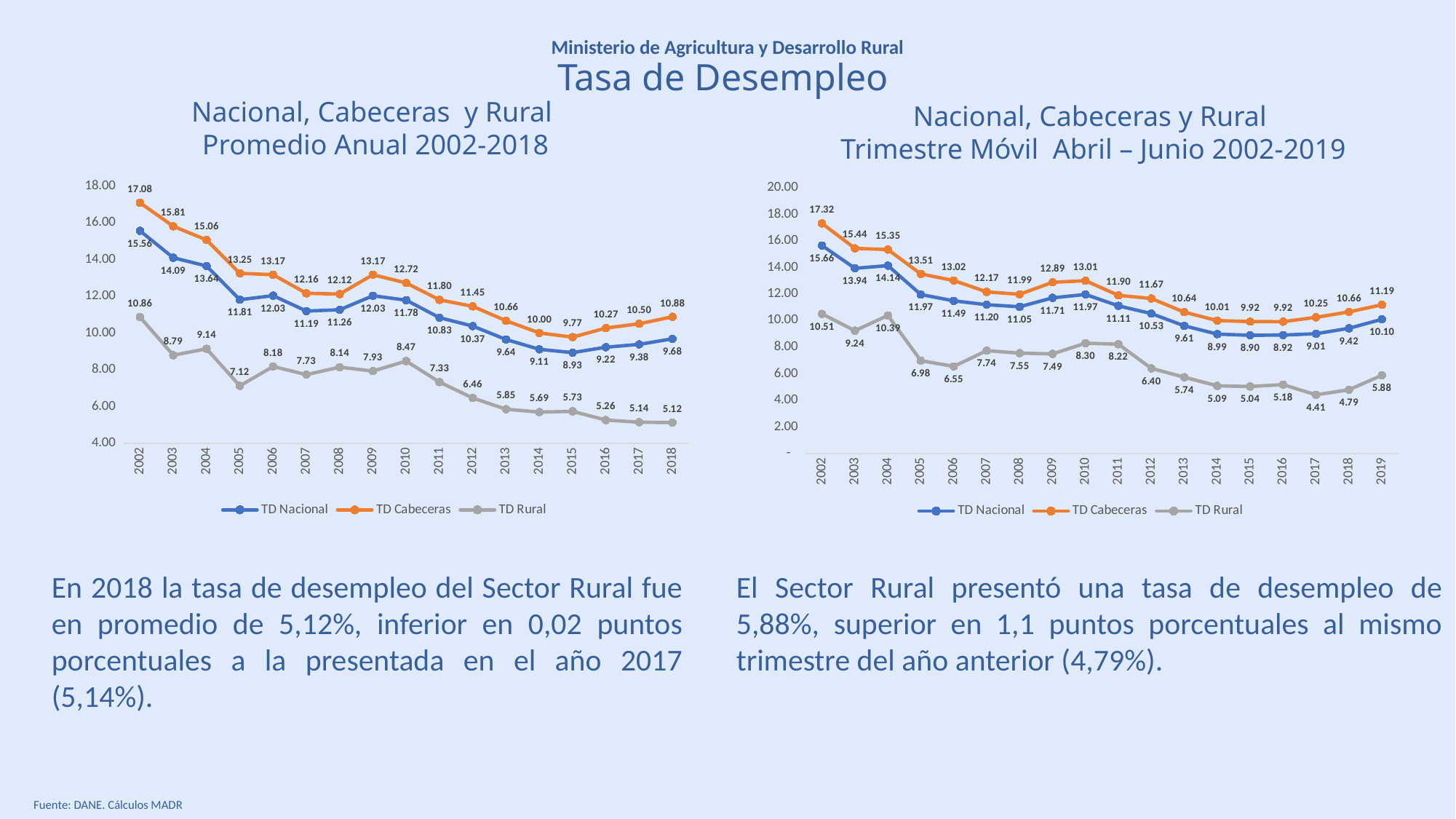
In the right chart (Trimestre Móvil Abril – Junio 2002-2019), what is the TD Rural value for 2019? 5.88 In the right chart (Trimestre Móvil Abril – Junio 2002-2019), what is the difference between the TD Rural values for 2019 and 2018? 1.09 How many series does the legend of the right chart (Trimestre Móvil Abril – Junio 2002-2019) list? 3 What type of chart is the left chart (Promedio Anual 2002-2018)? line chart In the left chart (Promedio Anual 2002-2018), what is the TD Rural value for 2018? 5.12 In the right chart (Trimestre Móvil Abril – Junio 2002-2019), in which year is TD Rural lowest? 2017 In the left chart (Promedio Anual 2002-2018), how many years are shown on the x axis? 17 In the right chart (Trimestre Móvil Abril – Junio 2002-2019), which is larger in 2019: TD Nacional or TD Cabeceras? TD Cabeceras In the left chart (Promedio Anual 2002-2018), what is the difference between TD Cabeceras and TD Rural in 2018? 5.76 In the left chart (Promedio Anual 2002-2018), in which year is TD Nacional lowest? 2015 In the left chart (Promedio Anual 2002-2018), does TD Rural generally rise or fall from 2002 to 2018? fall In the left chart (Promedio Anual 2002-2018), what is the TD Cabeceras value for 2002? 17.08